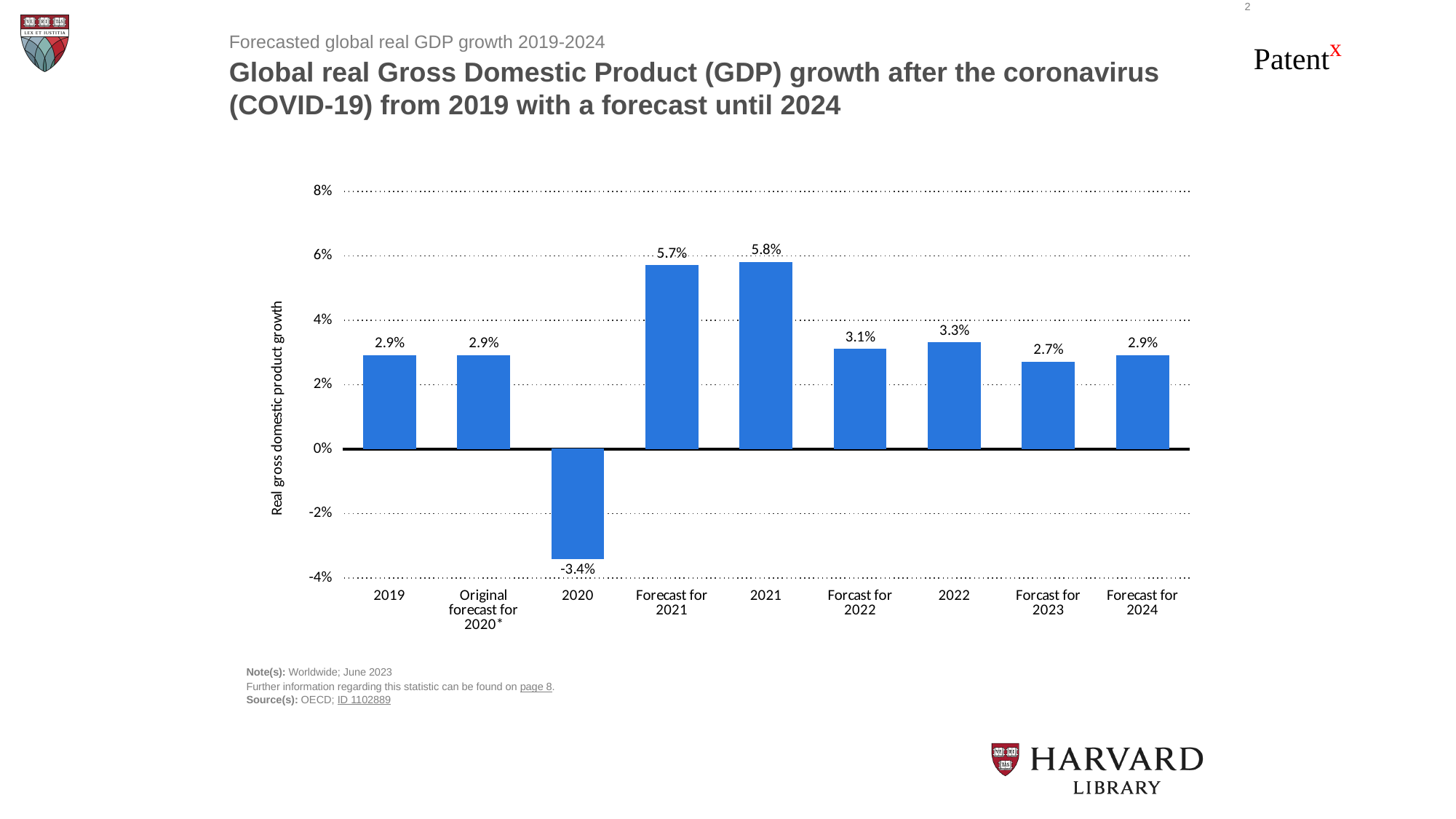
Is the value for 2021 greater or less than 4%? greater What is the difference between the value for 2021 and the value for 2022? 2.5% What is the value shown for 'Forcast for 2023'? 2.7% What is the value shown for 'Forecast for 2021'? 5.7% What is the real GDP growth value shown for 2020? -3.4% Which category has the lowest real GDP growth value? 2020 Which category has the highest real GDP growth value? 2021 Which is larger, the value for 'Forcast for 2022' or the value for 'Forecast for 2024'? Forcast for 2022 What kind of chart is shown on the slide? bar chart What is the label of the vertical axis? Real gross domestic product growth What is the difference between the value for 2019 and the value for 2020? 6.3% How many bars are plotted in the chart? 9